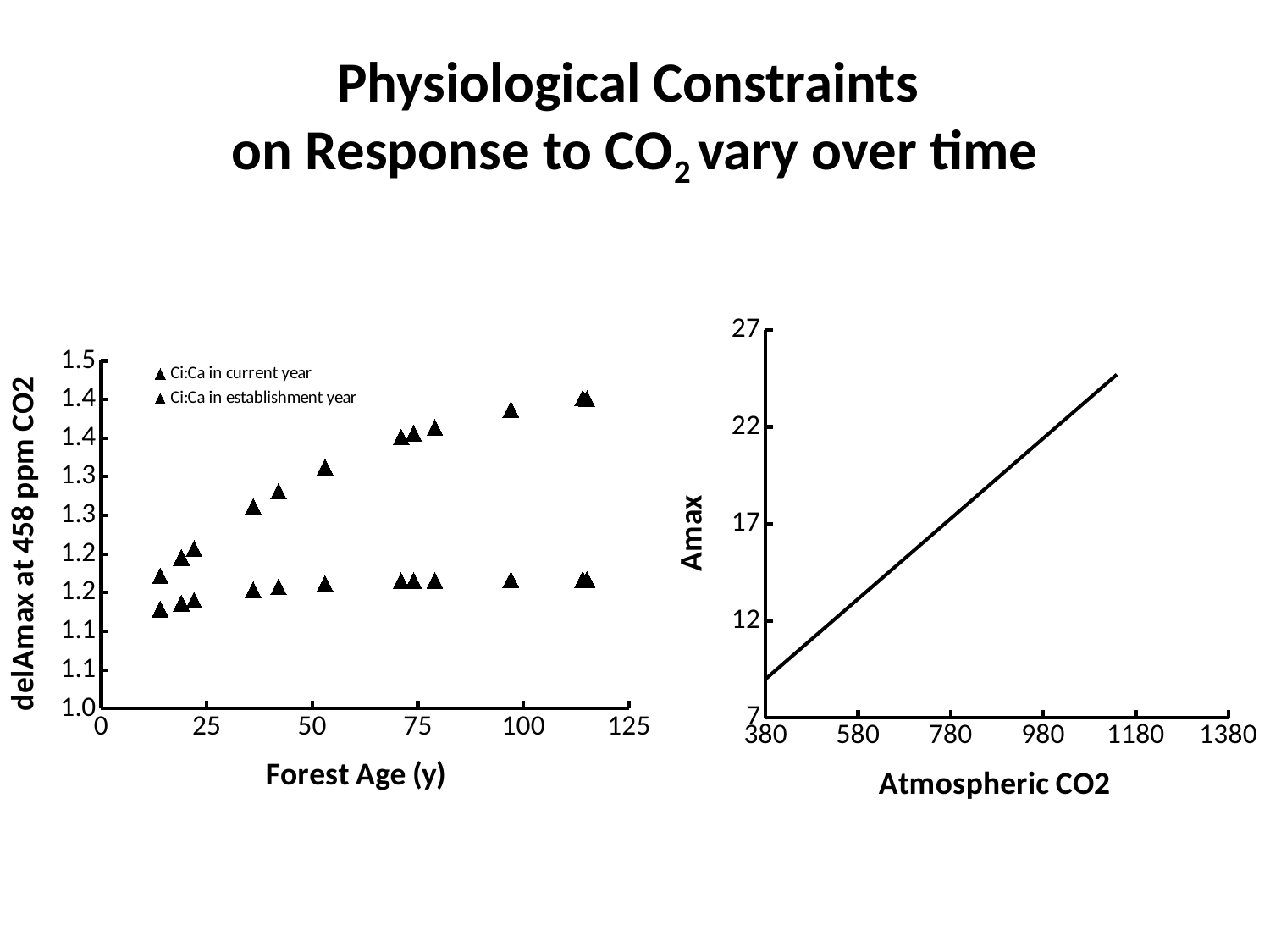
In the left chart, what is the title of the x axis? Forest Age (y) In the left chart (Forest Age), how many series does the legend list? 2 In the right chart (Atmospheric CO2), does Amax rise or fall as Atmospheric CO2 increases? rise What kind of chart is the left chart, plotting delAmax at 458 ppm CO2 against Forest Age (y)? scatter plot In the left chart (Forest Age), do the values for the Ci:Ca in current year series rise or fall as forest age increases? rise In the right chart (Atmospheric CO2), is the Amax value at 780 ppm greater or less than 12? greater What kind of chart is the right chart, plotting Amax against Atmospheric CO2? line chart In the right chart (Atmospheric CO2), is the Amax value at the right end of the line (around 1140 ppm) greater or less than 22? greater In the left chart (Forest Age), at a forest age of about 115 years, which series has the higher delAmax value: Ci:Ca in current year or Ci:Ca in establishment year? Ci:Ca in establishment year In the right chart (Atmospheric CO2), is the Amax value at 380 ppm greater or less than 12? less In the right chart (Atmospheric CO2), how many lines are plotted? 1 In the left chart (Forest Age), what are the two series named in the legend? Ci:Ca in current year; Ci:Ca in establishment year